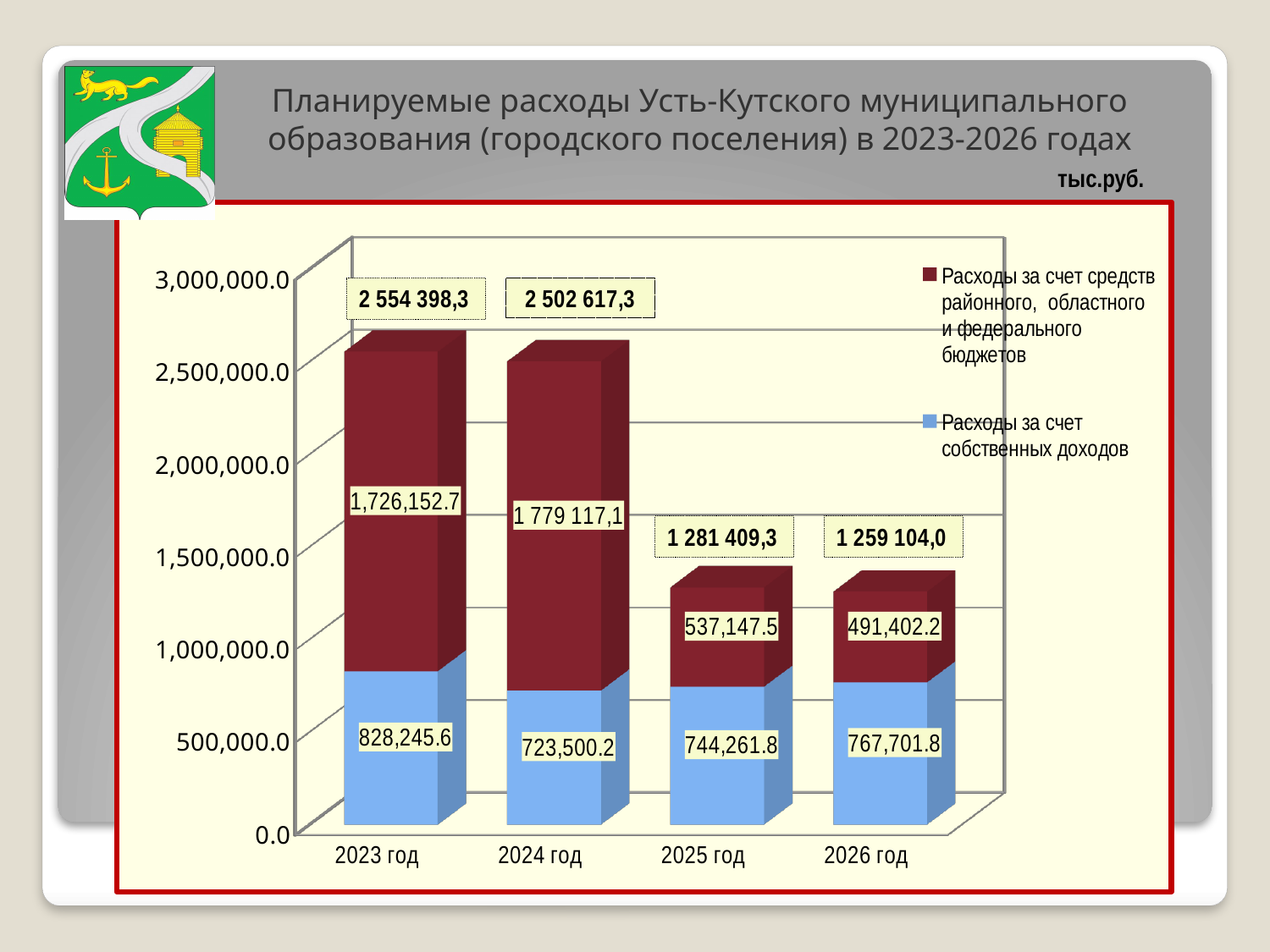
How many series does the legend list? 2 Which year has the highest total planned expenditure? 2023 год What unit of measurement is indicated above the chart? тыс.руб. What is the value for 'Расходы за счет средств районного, областного и федерального бюджетов' in 2026 год? 491,402.2 What is the value for 'Расходы за счет собственных доходов' in 2023 год? 828,245.6 What kind of chart is shown on the slide? Stacked bar chart How many years (categories) are shown on the x axis? 4 What is the total planned expenditure shown above the bar for 2025 год? 1 281 409,3 What is the difference between the 'Расходы за счет собственных доходов' values for 2026 год and 2025 год? 23,440.0 Which year has the lowest value for 'Расходы за счет собственных доходов'? 2024 год What is the value for 'Расходы за счет средств районного, областного и федерального бюджетов' in 2024 год? 1 779 117,1 Which is larger in 2025 год: 'Расходы за счет собственных доходов' or 'Расходы за счет средств районного, областного и федерального бюджетов'? Расходы за счет собственных доходов